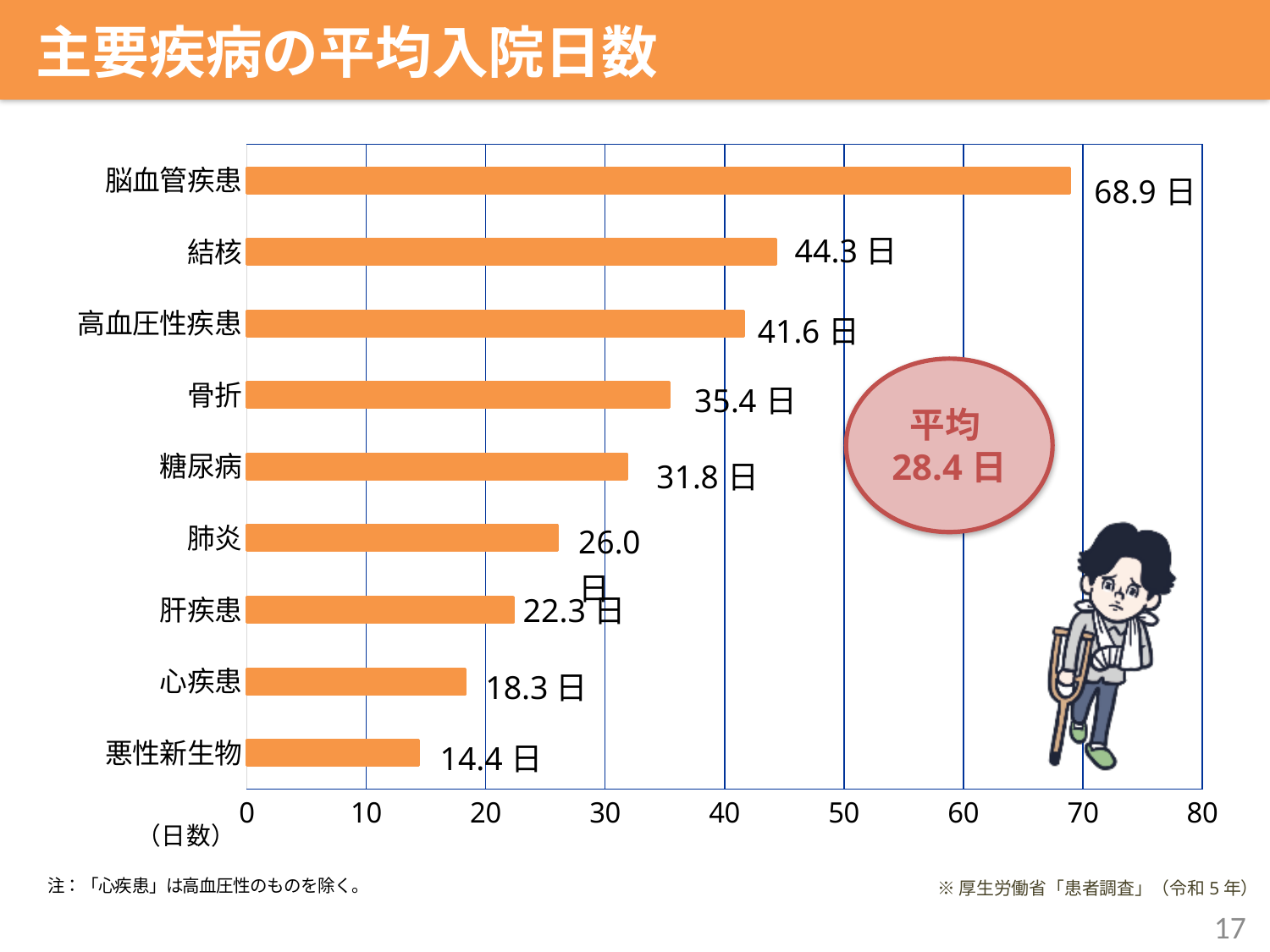
What is the difference in days between 脳血管疾患 and 結核? 24.6 日 Which disease has the shortest average hospital stay? 悪性新生物 How many diseases are shown in the chart? 9 Which has a longer average stay, 骨折 or 肺炎? 骨折 Is the value for 肝疾患 greater or less than 30? less What is the difference in days between 心疾患 and 悪性新生物? 3.9 日 What overall average number of days is shown in the circle on the chart? 28.4 日 What is the value shown for 糖尿病? 31.8 日 What is the average hospital stay for 脳血管疾患? 68.9 日 Which disease has the longest average hospital stay? 脳血管疾患 What is the value shown for 心疾患? 18.3 日 What kind of chart is shown on the slide? bar chart